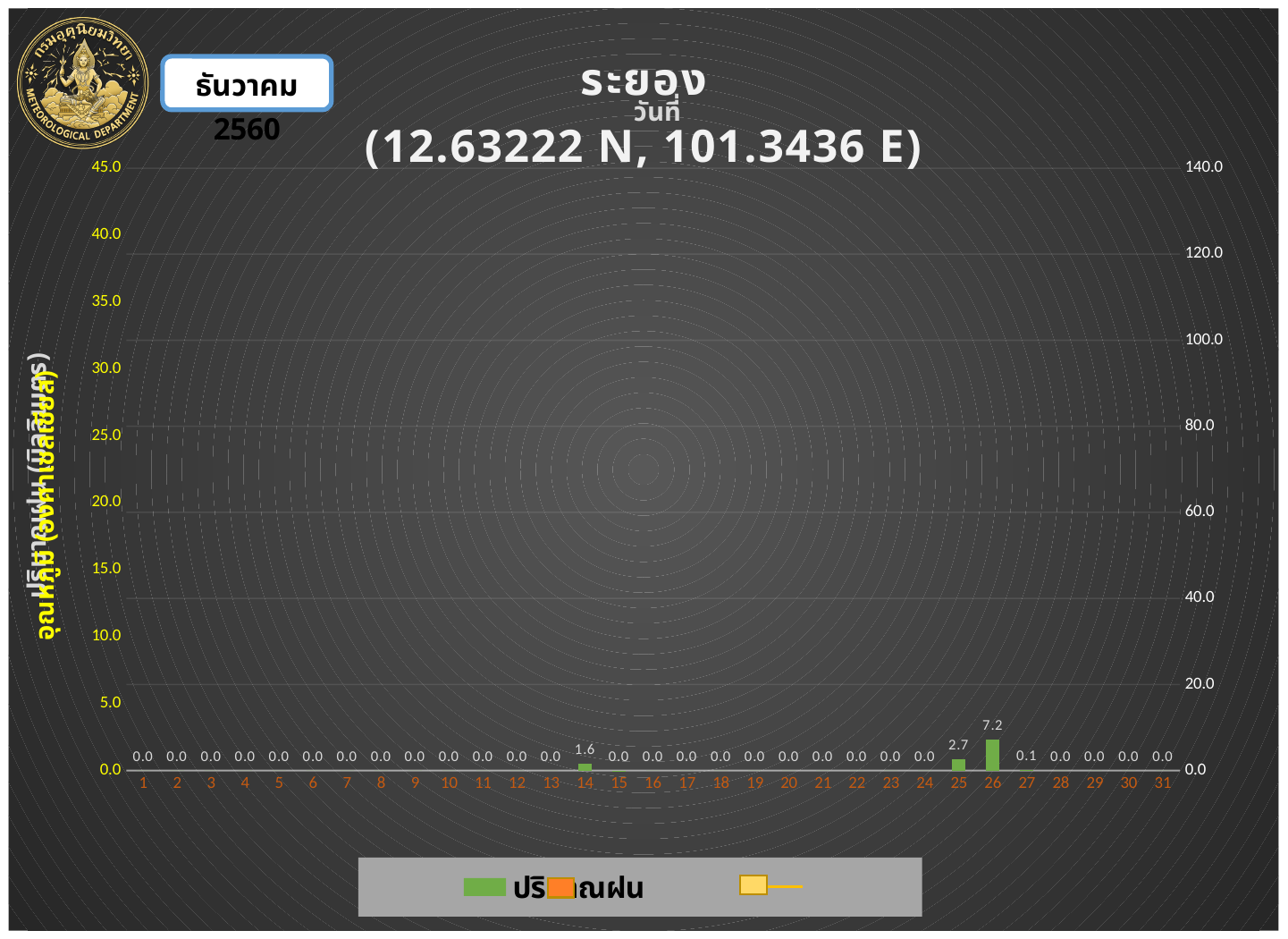
What is the highest tick value shown on the right-hand axis? 140.0 What is the rainfall value shown for day 27? 0.1 What is the difference between the rainfall values for day 26 and day 25? 4.5 What is the difference between the rainfall values for day 25 and day 14? 1.1 What kind of chart is shown on the slide? bar chart How many days (categories) are shown on the x axis? 31 What is the rainfall value shown for day 14? 1.6 What is the rainfall value shown for day 25? 2.7 Which has a larger rainfall value, day 14 or day 25? day 25 Which day has the highest rainfall value? 26 What is the rainfall value shown for day 26? 7.2